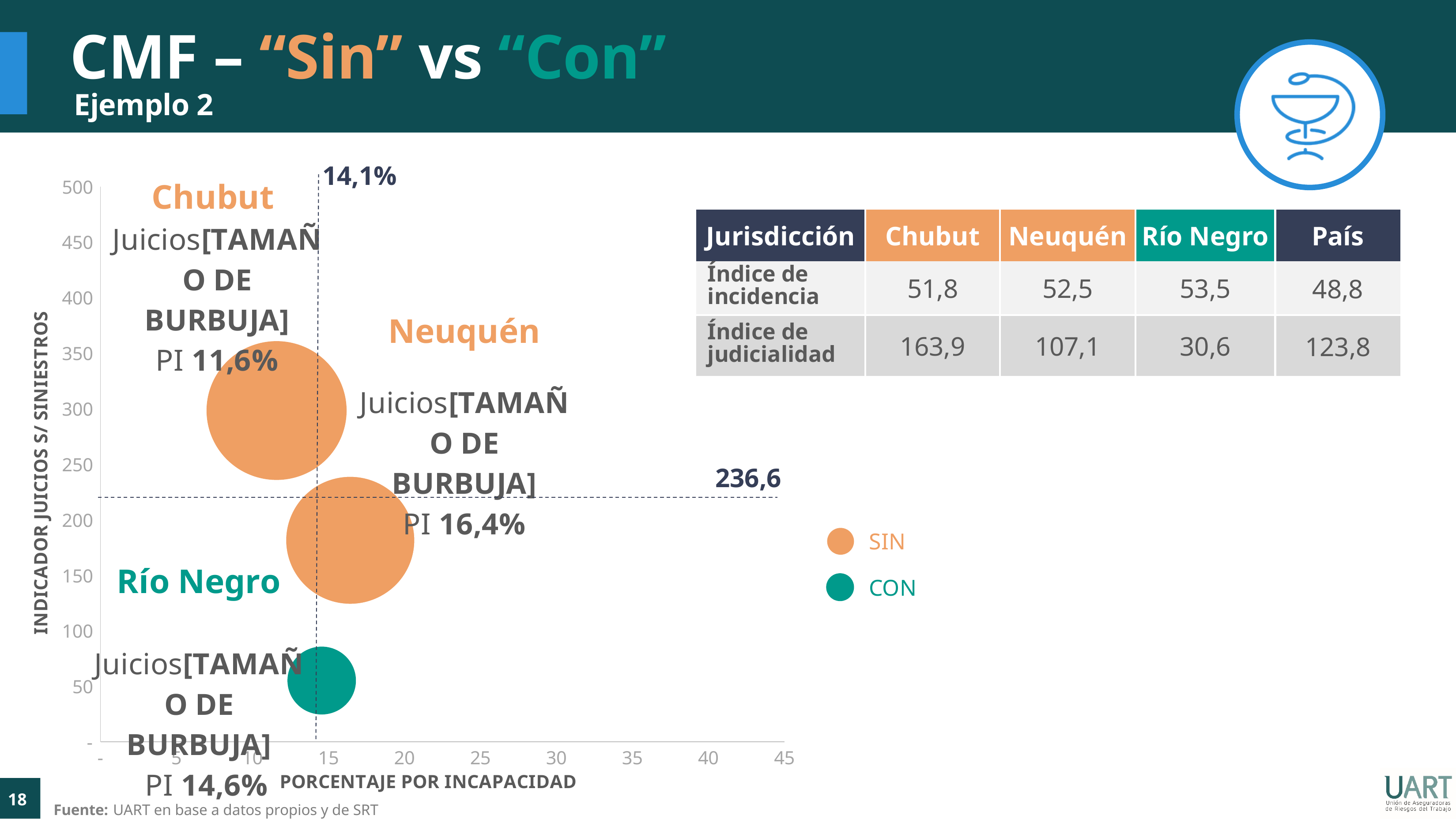
Which jurisdiction has the highest PI value in the chart? Neuquén Which jurisdiction has the lowest PI value in the chart? Chubut What is the PI (porcentaje por incapacidad) value shown for Chubut? 11,6% Is the indicador juicios s/ siniestros value for Río Negro greater or less than 100? less Is the indicador juicios s/ siniestros value for Chubut greater or less than 250? greater What kind of chart is shown on the slide? bubble chart What is the difference between the PI values of Neuquén and Chubut? 4,8% How many series does the chart legend list? 2 How many jurisdictions are plotted as bubbles in the chart? 3 Which jurisdiction is plotted in the CON series (green bubble)? Río Negro What is the PI value shown for Neuquén? 16,4% What is the PI value shown for Río Negro? 14,6%